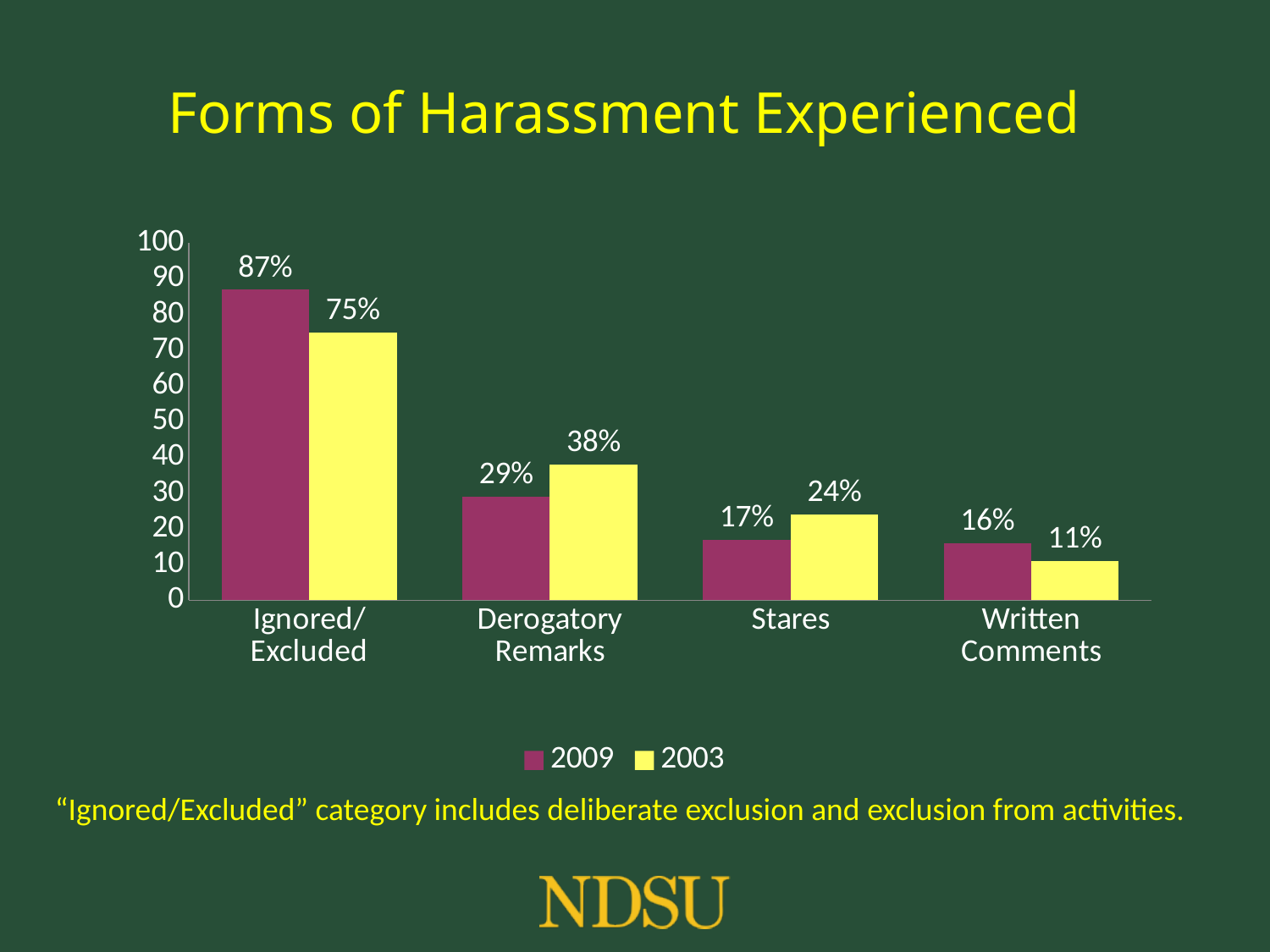
Which is larger for Derogatory Remarks, the 2009 value or the 2003 value? 2003 What kind of chart is shown on the slide? bar chart What is the difference between the 2009 and 2003 values for Ignored/Excluded? 12% Which category has the lowest 2003 value? Written Comments Which category has the highest 2009 value? Ignored/Excluded What is the difference between the 2003 and 2009 values for Stares? 7% What is the 2009 value for Ignored/Excluded? 87% Is the 2003 value for Stares greater or less than 20? greater What is the 2003 value for Derogatory Remarks? 38% How many series does the legend list? 2 What is the 2003 value for Written Comments? 11% How many categories are shown on the x axis? 4